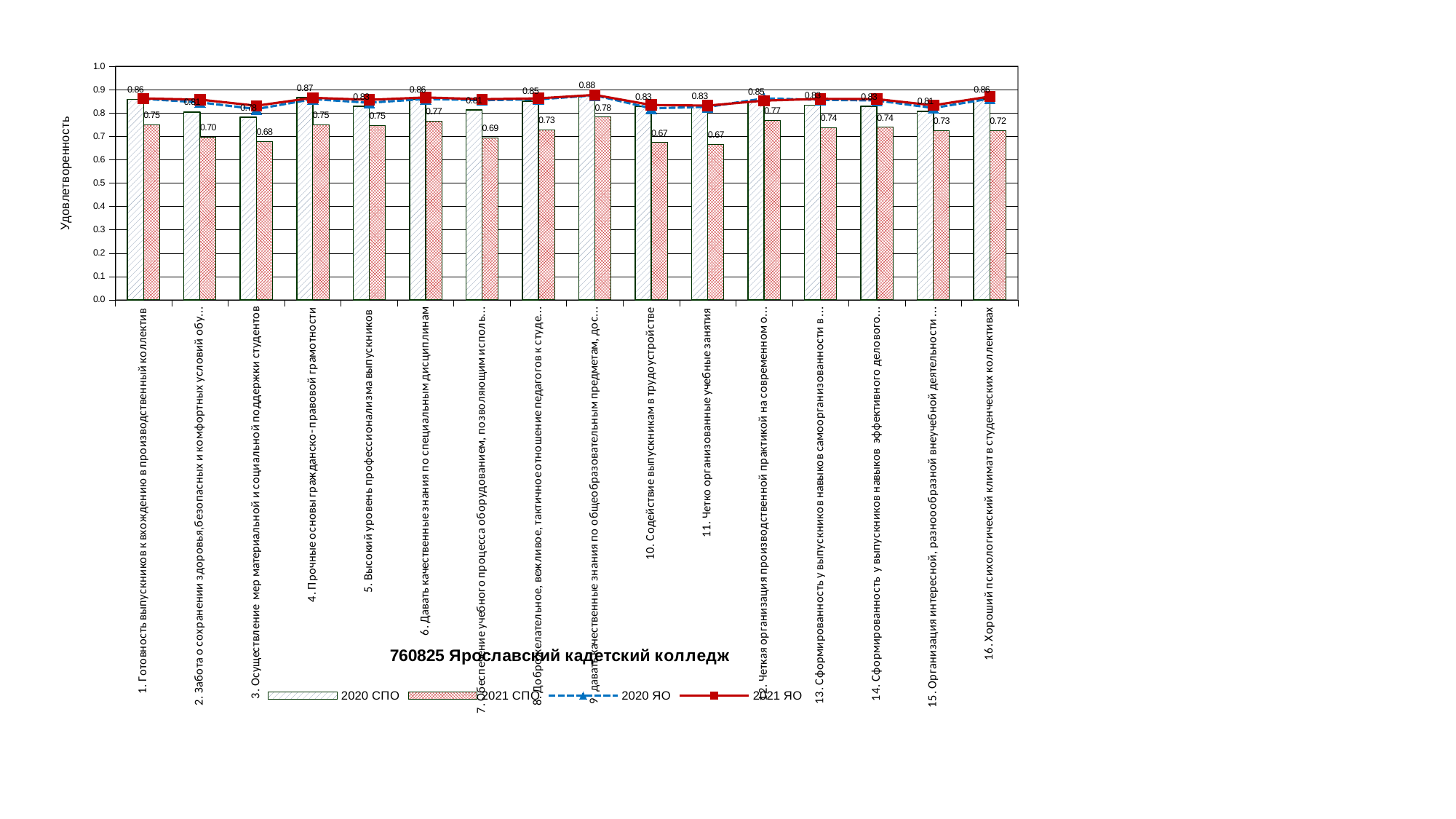
What is the 2021 СПО value for category 10 (Содействие выпускникам в трудоустройстве)? 0.67 What is the 2020 СПО value for category 4 (Прочные основы гражданско-правовой грамотности)? 0.87 How many series does the legend list? 4 Is the 2021 СПО value for category 3 (Осуществление мер материальной и социальной поддержки студентов) greater or less than 0.7? less What kind of chart is shown on the slide? A bar chart combined with line series For category 1 (Готовность выпускников к вхождению в производственный коллектив), what is the difference between the 2020 СПО value and the 2021 СПО value? 0.11 How many categories are plotted along the x axis? 16 What is the 2021 СПО value for category 9 (Давать качественные знания по общеобразовательным предметам)? 0.78 Which has the larger 2021 СПО value: category 6 (Давать качественные знания по специальным дисциплинам) or category 16 (Хороший психологический климат в студенческих коллективах)? Category 6 What is the lowest 2021 СПО value shown on the chart? 0.67 Which category has the highest 2021 СПО value? 9. Давать качественные знания по общеобразовательным предметам What is the label on the vertical axis? Удовлетворенность